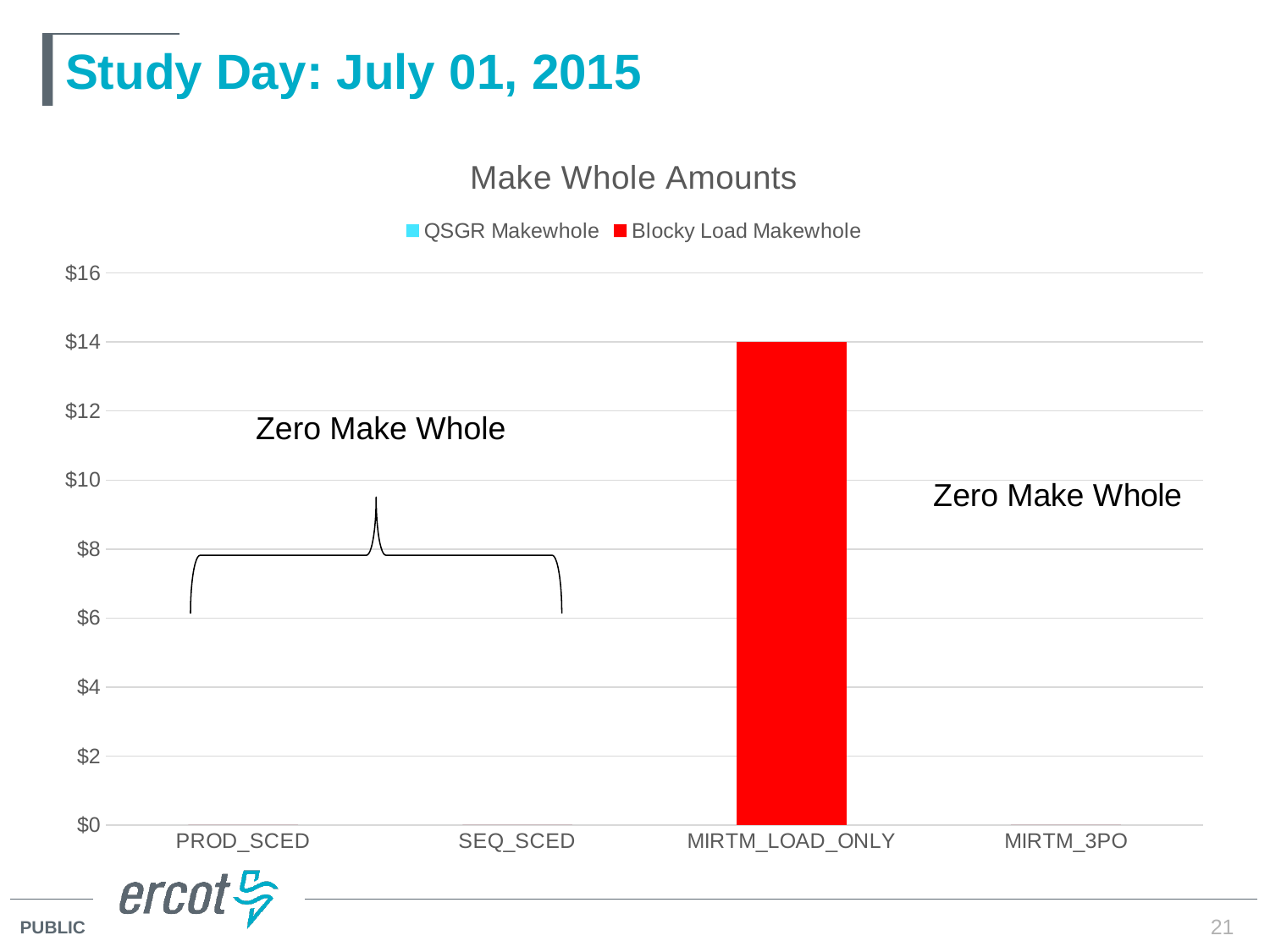
How many categories are annotated as having zero make whole? 3 Which category has the highest make whole amount? MIRTM_LOAD_ONLY How many series does the legend list? 2 Which series is shown in red in the legend? Blocky Load Makewhole Which is larger, the value for MIRTM_LOAD_ONLY or the value for MIRTM_3PO? MIRTM_LOAD_ONLY What is the highest value shown on the y axis? $16 What is the title of the chart? Make Whole Amounts What is the Blocky Load Makewhole value for MIRTM_LOAD_ONLY? $14 Is the value for MIRTM_LOAD_ONLY greater or less than $10? greater How many categories are shown on the x axis? 4 What kind of chart is shown on the slide? bar chart